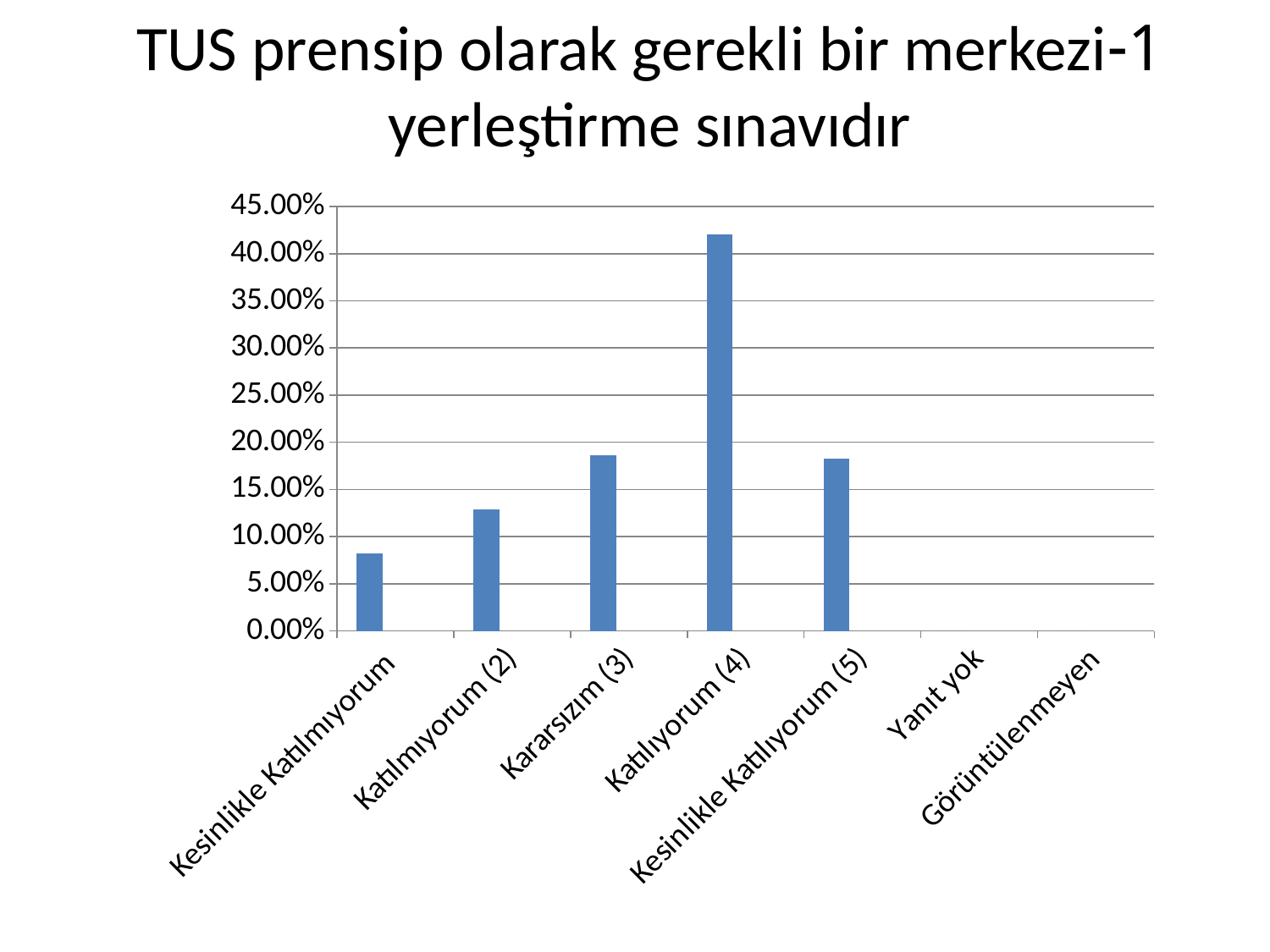
Which is larger, the value for Katılmıyorum (2) or the value for Kararsızım (3)? Kararsızım (3) Is the value for Kesinlikle Katılmıyorum greater or less than 10.00%? less Which is larger, the value for Katılıyorum (4) or the value for Kesinlikle Katılıyorum (5)? Katılıyorum (4) Is the value for Kesinlikle Katılıyorum (5) greater or less than 15.00%? greater What is the title of the slide? TUS prensip olarak gerekli bir merkezi-1 yerleştirme sınavıdır Among the categories with a visible bar, which has the lowest value? Kesinlikle Katılmıyorum How many categories are shown on the x axis of the chart? 7 Is the value for Katılıyorum (4) greater or less than 40.00%? greater What kind of chart is shown on the slide? bar chart Which category has the highest value in the chart? Katılıyorum (4)